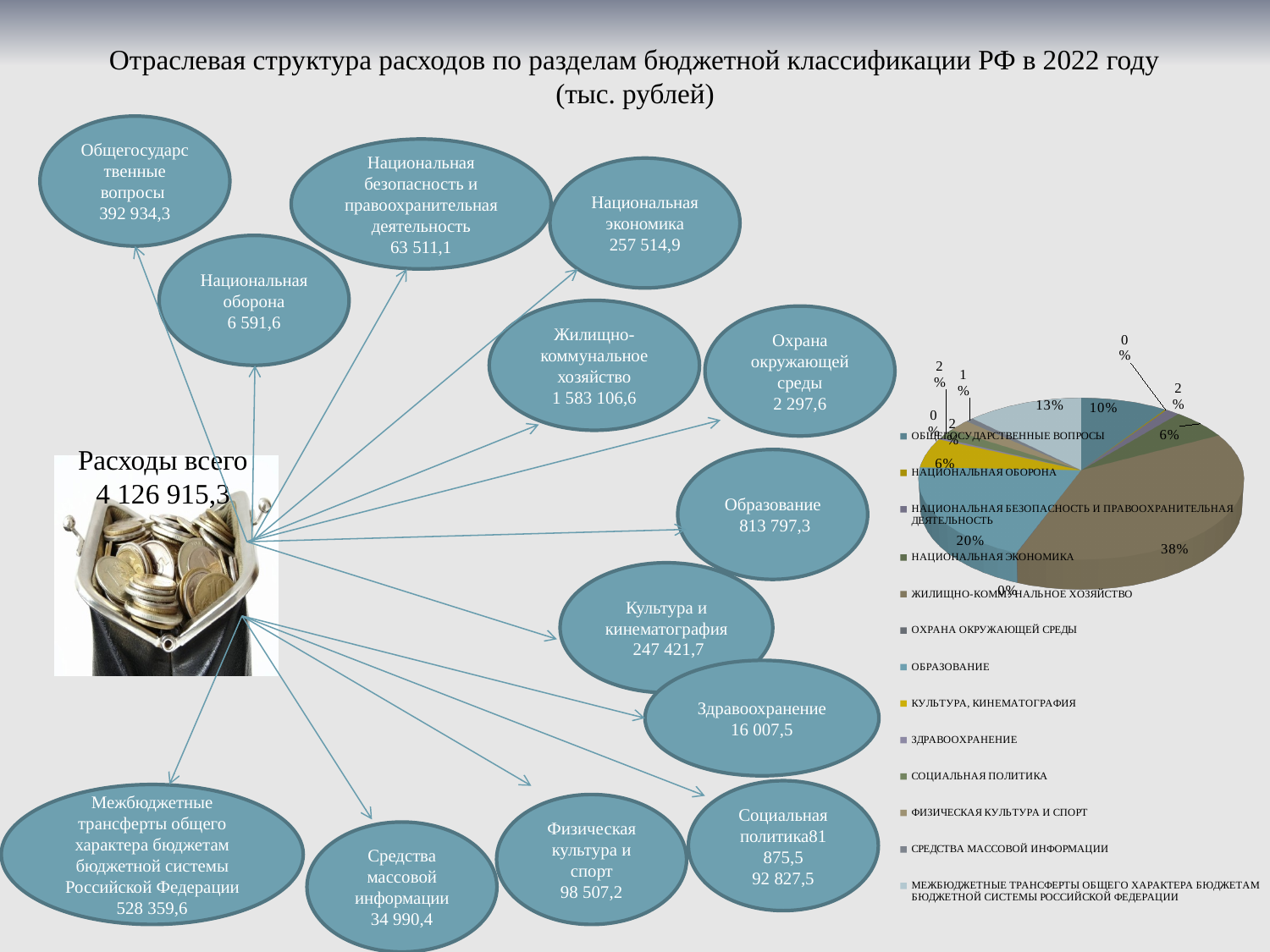
What is the title of the slide containing the pie chart? Отраслевая структура расходов по разделам бюджетной классификации РФ в 2022 году (тыс. рублей) Which category has the largest slice of the pie chart? Жилищно-коммунальное хозяйство What is the largest percentage label shown on the pie chart? 38% What is the second-largest percentage label shown on the pie chart? 20% What is the first category listed in the pie chart legend? Общегосударственные вопросы What is the smallest percentage label shown on the pie chart? 0% What is the total of the 38%, 20% and 13% slices of the pie chart? 71% What kind of chart is shown on the right side of the slide? pie chart What is the difference between the largest slice (38%) and the 20% slice of the pie chart? 18% How many categories does the legend of the pie chart list? 13 Is the largest slice of the pie chart greater or less than 30%? greater Which is larger on the pie chart: the 13% slice or the 10% slice? 13%